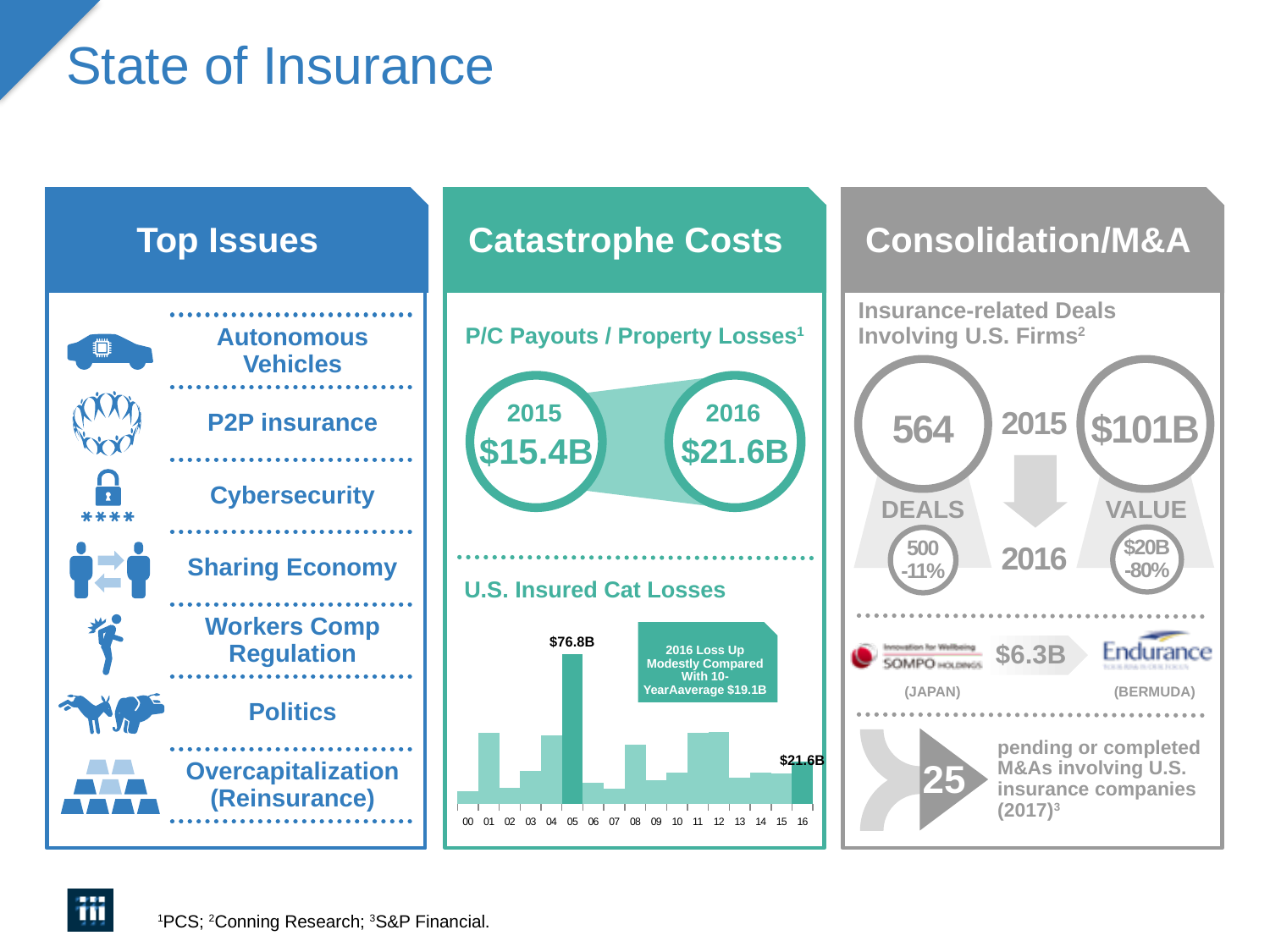
In the U.S. Insured Cat Losses chart, what is the difference between the 05 value and the 16 value? $55.2B In the U.S. Insured Cat Losses chart, which year has the larger value, 04 or 06? 04 In the U.S. Insured Cat Losses chart, which year has the highest insured cat losses? 05 In the U.S. Insured Cat Losses chart, what is the value labelled for the year 05? $76.8B According to the callout on the U.S. Insured Cat Losses chart, what is the 10-year average loss? $19.1B In the U.S. Insured Cat Losses chart, which year has the larger value, 01 or 02? 01 What is the title of the bar chart on the slide? U.S. Insured Cat Losses How many years (bars) are shown on the x axis of the U.S. Insured Cat Losses chart? 17 What kind of chart is the U.S. Insured Cat Losses chart? bar chart In the U.S. Insured Cat Losses chart, which year has the larger value, 05 or 16? 05 In the U.S. Insured Cat Losses chart, what is the value labelled for the year 16? $21.6B